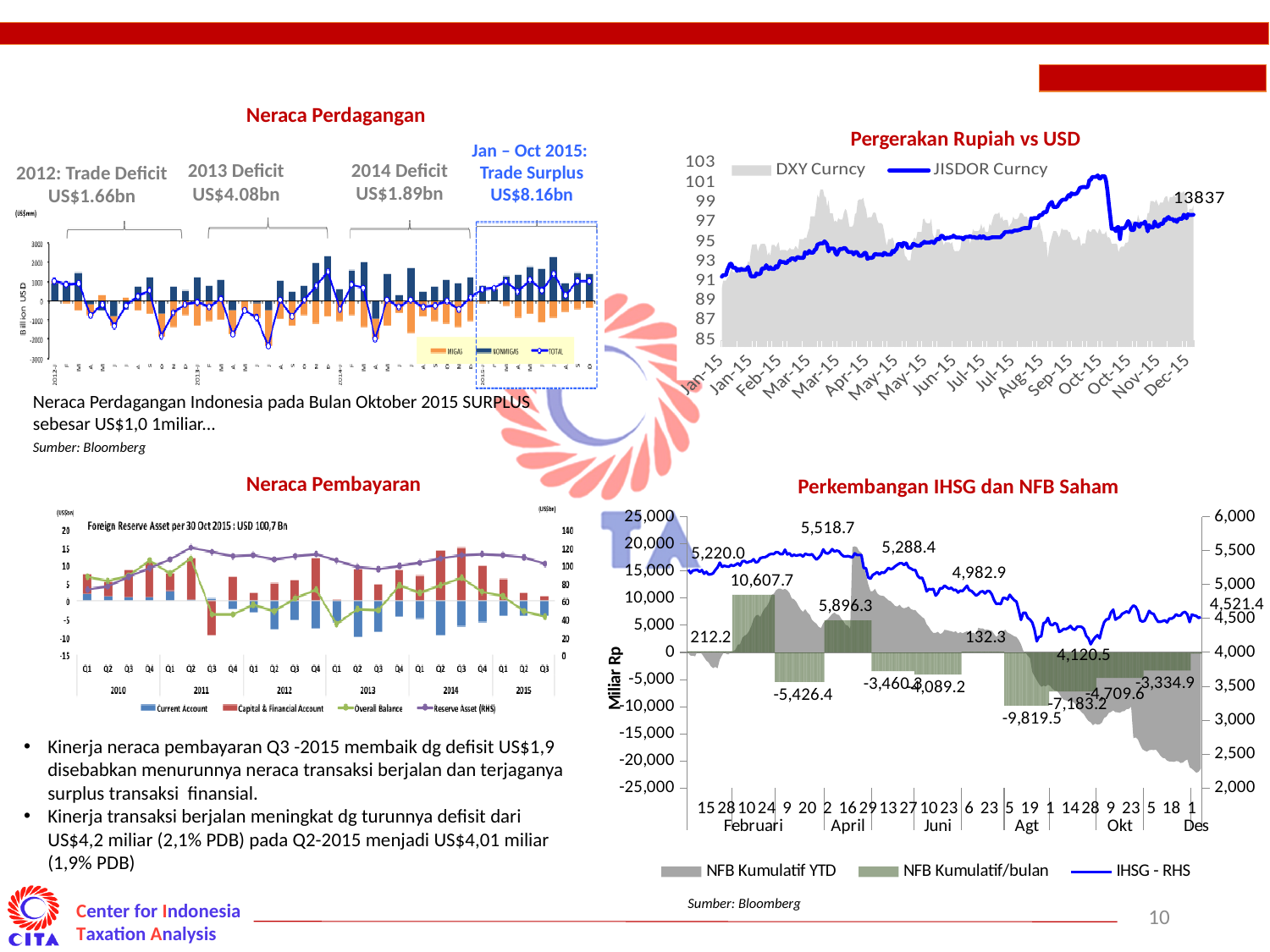
In the 'Pergerakan Rupiah vs USD' chart, how many series does the legend list? 2 In the 'Perkembangan IHSG dan NFB Saham' chart, which is larger: the NFB label 10,607.7 or 5,896.3? 10,607.7 In the 'Neraca Perdagangan' chart, what was the trade surplus for Jan – Oct 2015? US$8.16bn In the 'Perkembangan IHSG dan NFB Saham' chart, what is the lowest labelled NFB value? -9,819.5 In the 'Perkembangan IHSG dan NFB Saham' chart, what is the highest labelled value of the IHSG line? 5,518.7 In the 'Perkembangan IHSG dan NFB Saham' chart, what is the largest labelled monthly NFB value? 10,607.7 In the 'Perkembangan IHSG dan NFB Saham' chart, how many series does the legend list? 3 In the 'Neraca Pembayaran' chart, how many series does the legend list? 4 In the 'Neraca Perdagangan' chart, which year had the largest annotated trade deficit? 2013 In the 'Perkembangan IHSG dan NFB Saham' chart, what is the last labelled value of the IHSG line (near Des)? 4,521.4 In the 'Perkembangan IHSG dan NFB Saham' chart, what is the difference between the IHSG labels 5,518.7 and 4,521.4? 997.3 In the 'Pergerakan Rupiah vs USD' chart, what value is labelled at the end of the JISDOR Curncy line? 13837